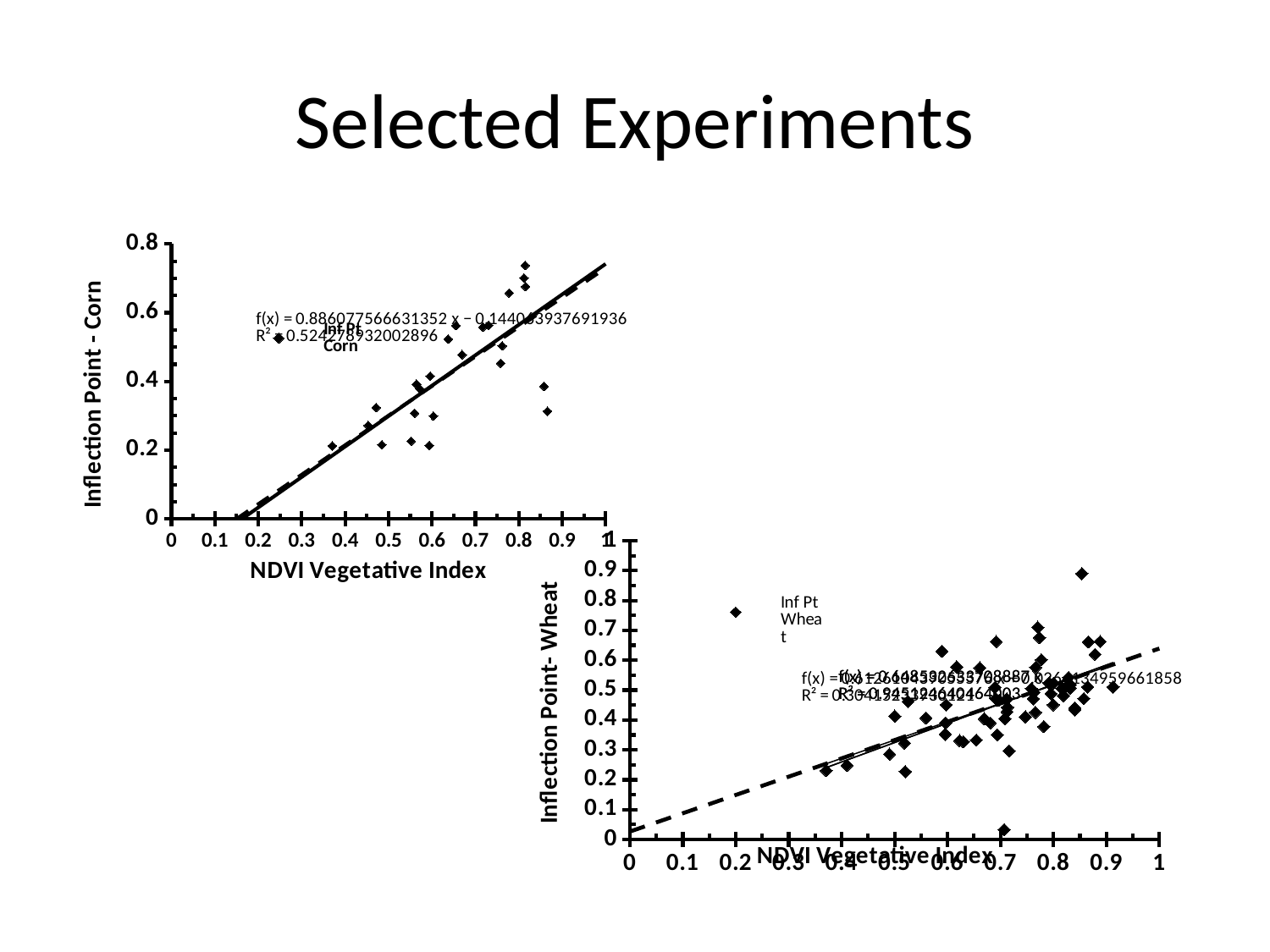
On the right chart (Inflection Point- Wheat), is the lowest plotted point greater or less than 0.1 on the y axis? less On the right chart, what is the title of the y axis? Inflection Point- Wheat On the left chart (Inflection Point - Corn), is the highest plotted point greater or less than 0.6 on the y axis? greater What kind of chart is the left chart (Inflection Point - Corn)? scatter chart On the right chart (Inflection Point- Wheat), is the highest plotted point greater or less than 0.8 on the y axis? greater What is the highest tick value shown on the y axis of the left chart (Inflection Point - Corn)? 0.8 On the left chart (Inflection Point - Corn), what R² value is printed for the trendline? 0.524278932002896 What kind of chart is the right chart (Inflection Point- Wheat)? scatter chart On the left chart (Inflection Point - Corn), do the plotted values generally rise or fall as the NDVI Vegetative Index increases? rise On the left chart, what is the title of the x axis? NDVI Vegetative Index On the left chart (Inflection Point - Corn), what is the slope of the printed trendline equation f(x)? 0.886077566631352 On the right chart (Inflection Point- Wheat), do the plotted values generally rise or fall as the NDVI Vegetative Index increases? rise